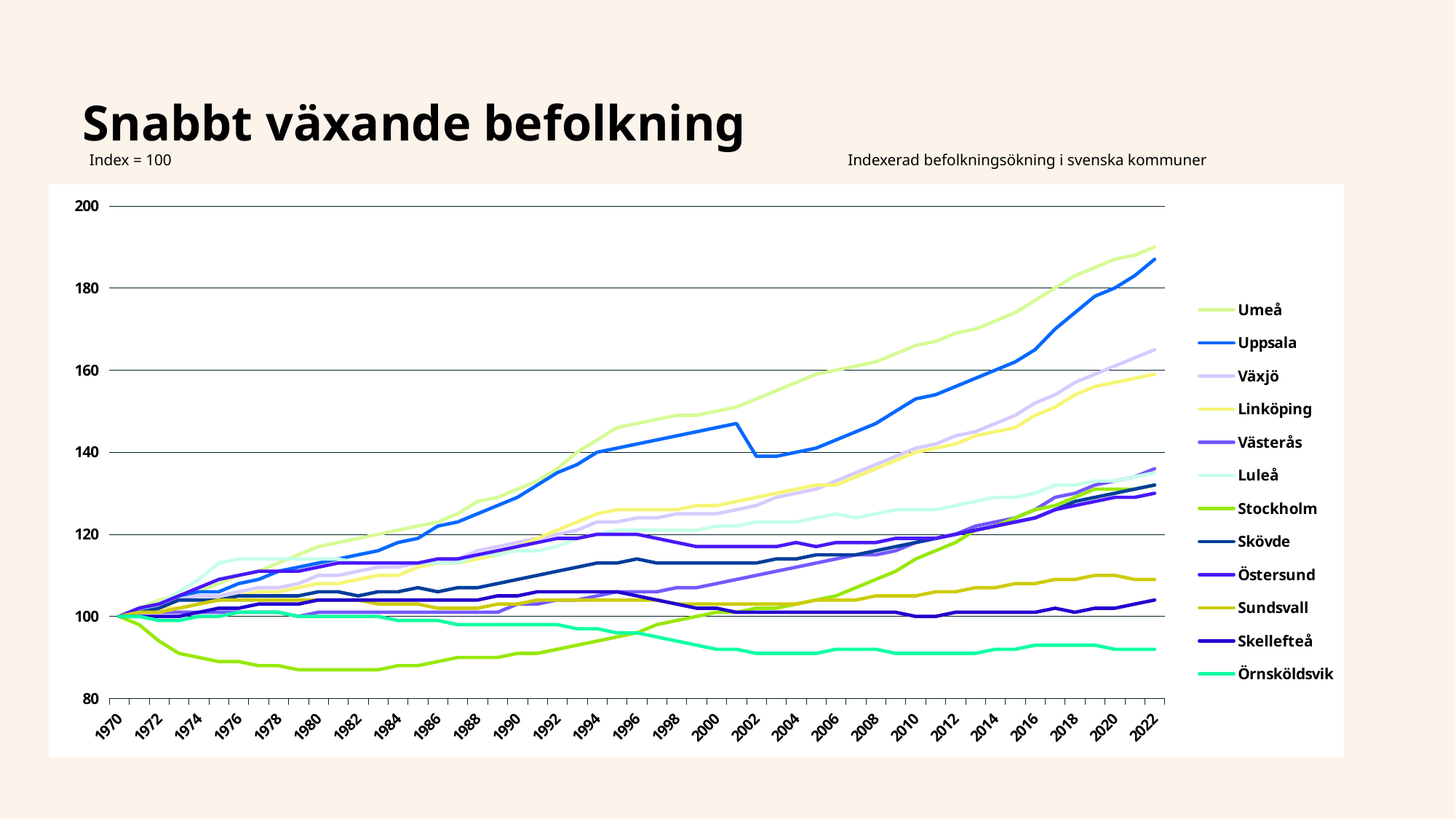
Is the value for Stockholm in 1980 greater or less than 100? less How many series does the legend list? 12 Which municipality has the lowest index value in 2022? Örnsköldsvik Which is larger in 2022, the value for Uppsala or the value for Stockholm? Uppsala Which municipality has the highest index value in 2022? Umeå What is the title of the slide? Snabbt växande befolkning Is the value for Örnsköldsvik in 2022 greater or less than 100? less What kind of chart is shown on the slide? line chart What base value is the index set to, according to the note above the chart? Index = 100 Does the line for Umeå rise or fall from 1970 to 2022? rise Is the value for Skellefteå in 2022 greater or less than 120? less